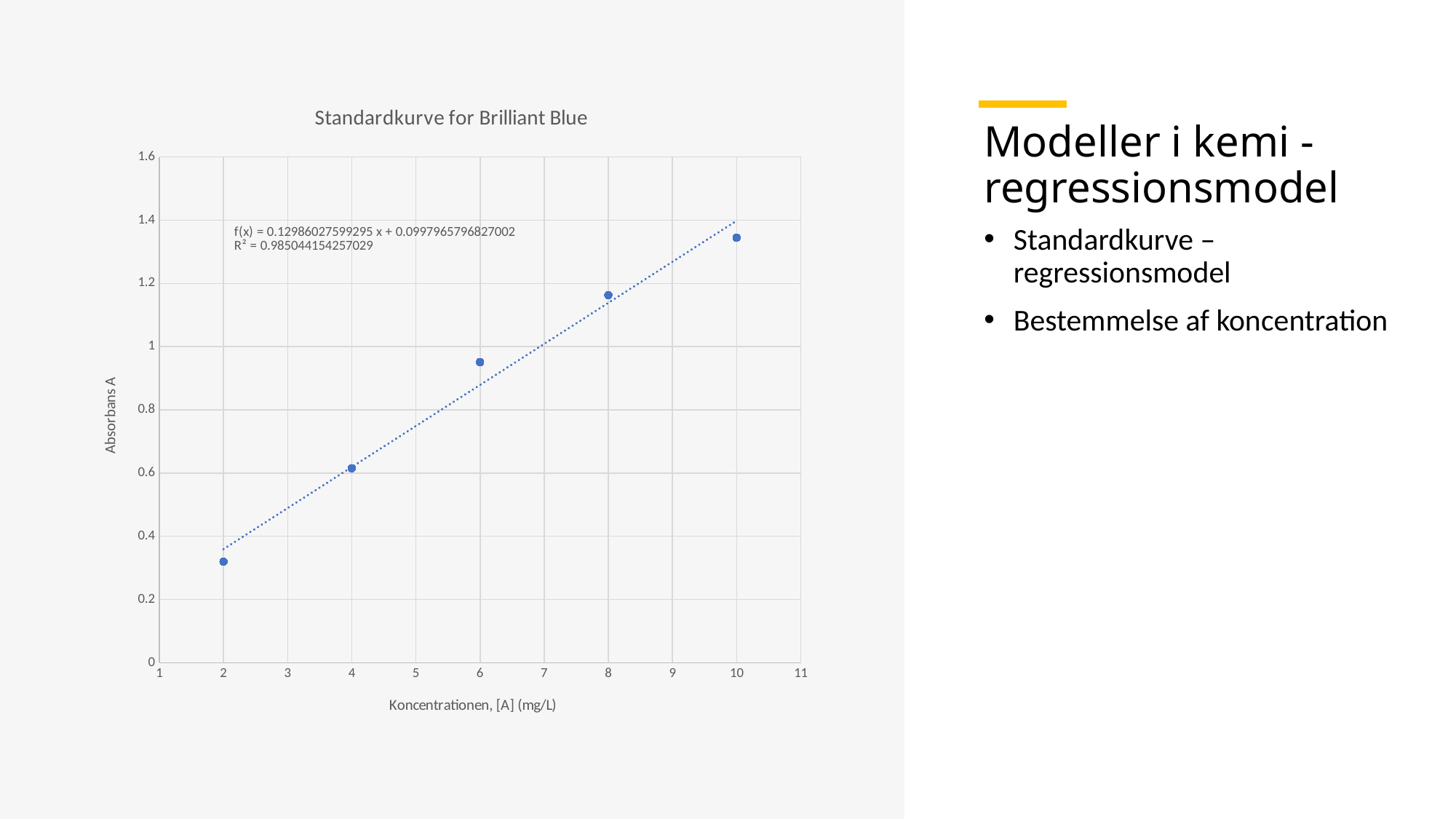
How many data points are plotted in the chart? 5 Do the absorbance values rise or fall as the concentration increases along the x axis? rise What kind of chart is shown on the slide? scatter plot What is the title of the chart? Standardkurve for Brilliant Blue Is the absorbance value at concentration 10 greater or less than 1.2? greater Which has the larger absorbance value, concentration 4 or concentration 8? 8 Which concentration has the lowest absorbance value? 2 Is the absorbance value at concentration 4 greater or less than 0.8? less Is the absorbance value at concentration 6 greater or less than 0.8? greater Which concentration has the highest absorbance value? 10 What is the R² value shown on the chart? 0.985044154257029